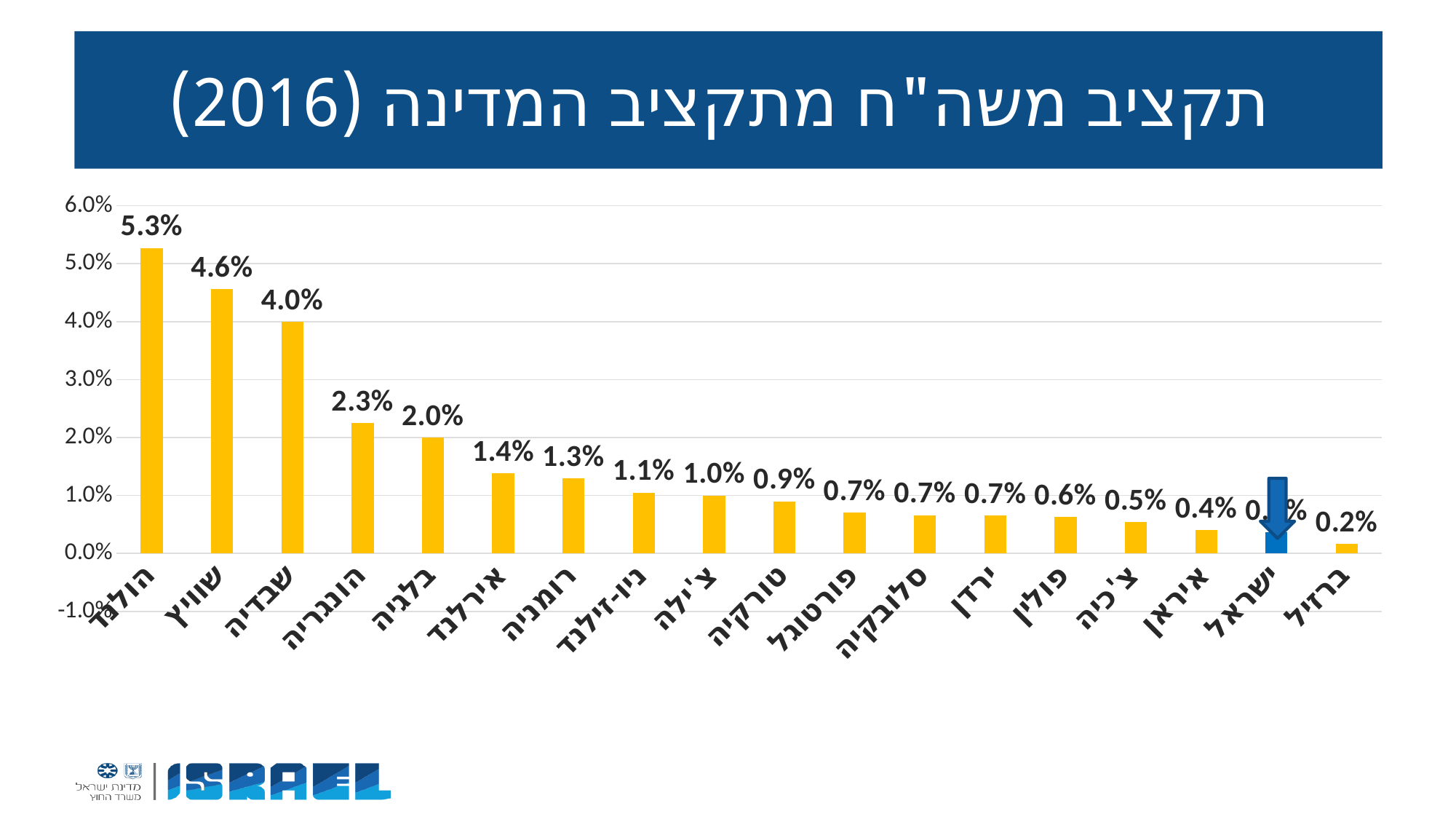
Which bar is coloured blue instead of yellow? ישראל Which has a larger value, בלגיה or אירלנד? בלגיה What kind of chart is shown on the slide? bar chart What is the value for שבדיה? 4.0% Is the value for ישראל greater or less than 1.0%? less What is the value for ברזיל? 0.2% Which country has the lowest value? ברזיל What is the value for הולנד? 5.3% How many countries are shown in the chart? 18 What is the difference between the values for הולנד and שוויץ? 0.7% Which country has the highest value? הולנד What is the value for הונגריה? 2.3%